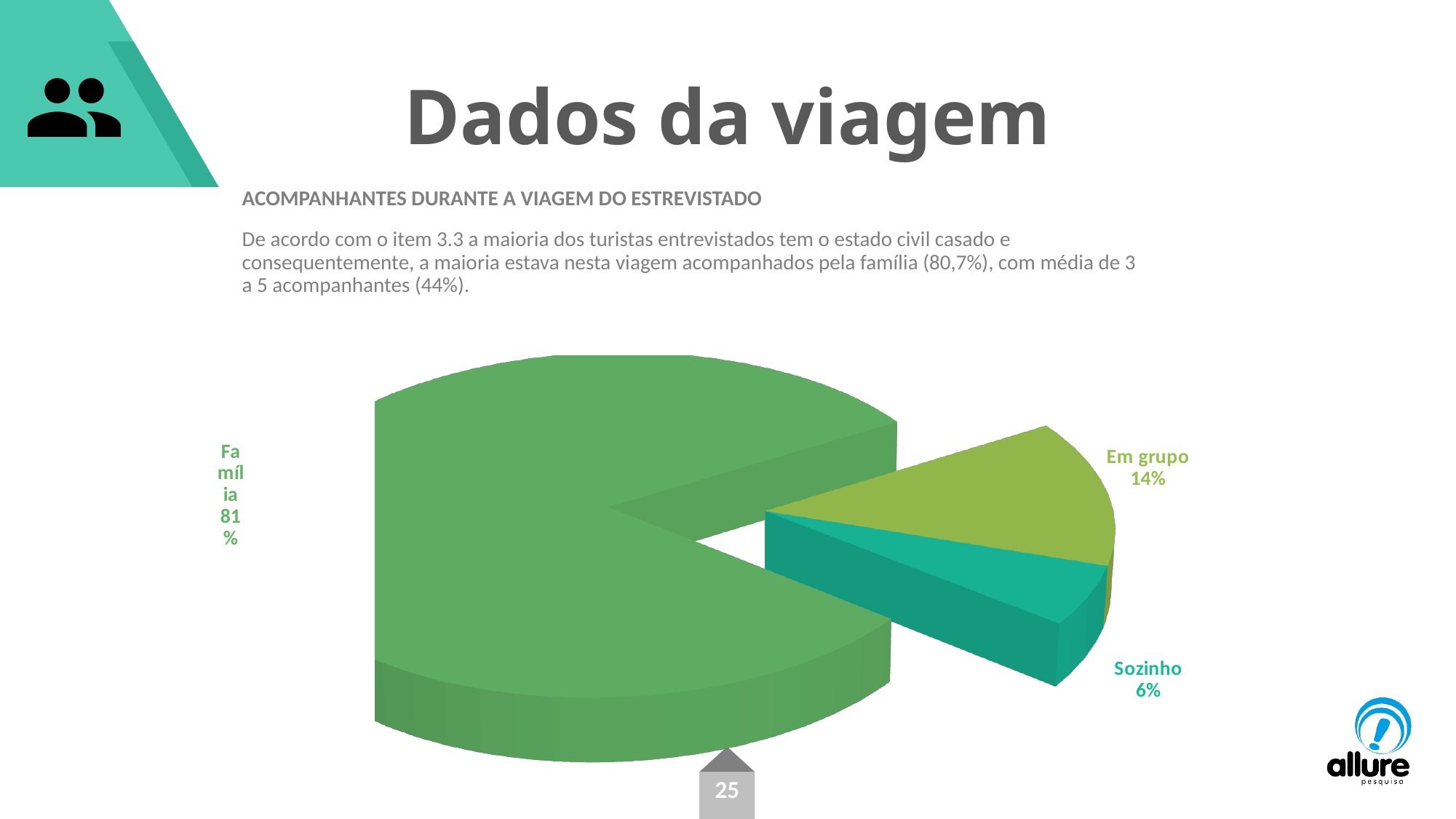
What share of the pie does Sozinho represent? 6% What share of the pie does Em grupo represent? 14% What is the heading printed above the chart? ACOMPANHANTES DURANTE A VIAGEM DO ESTREVISTADO Which is larger, the share for Em grupo or the share for Sozinho? Em grupo What is the difference in percentage points between Em grupo and Sozinho? 8 What kind of chart is shown on the slide? Pie chart How many categories are shown in the pie chart? 3 What share of the pie does Família represent? 81% Which category has the largest slice of the pie? Família Which category has the smallest slice of the pie? Sozinho What is the combined share of Em grupo and Sozinho? 20% What is the difference in percentage points between Família and Em grupo? 67